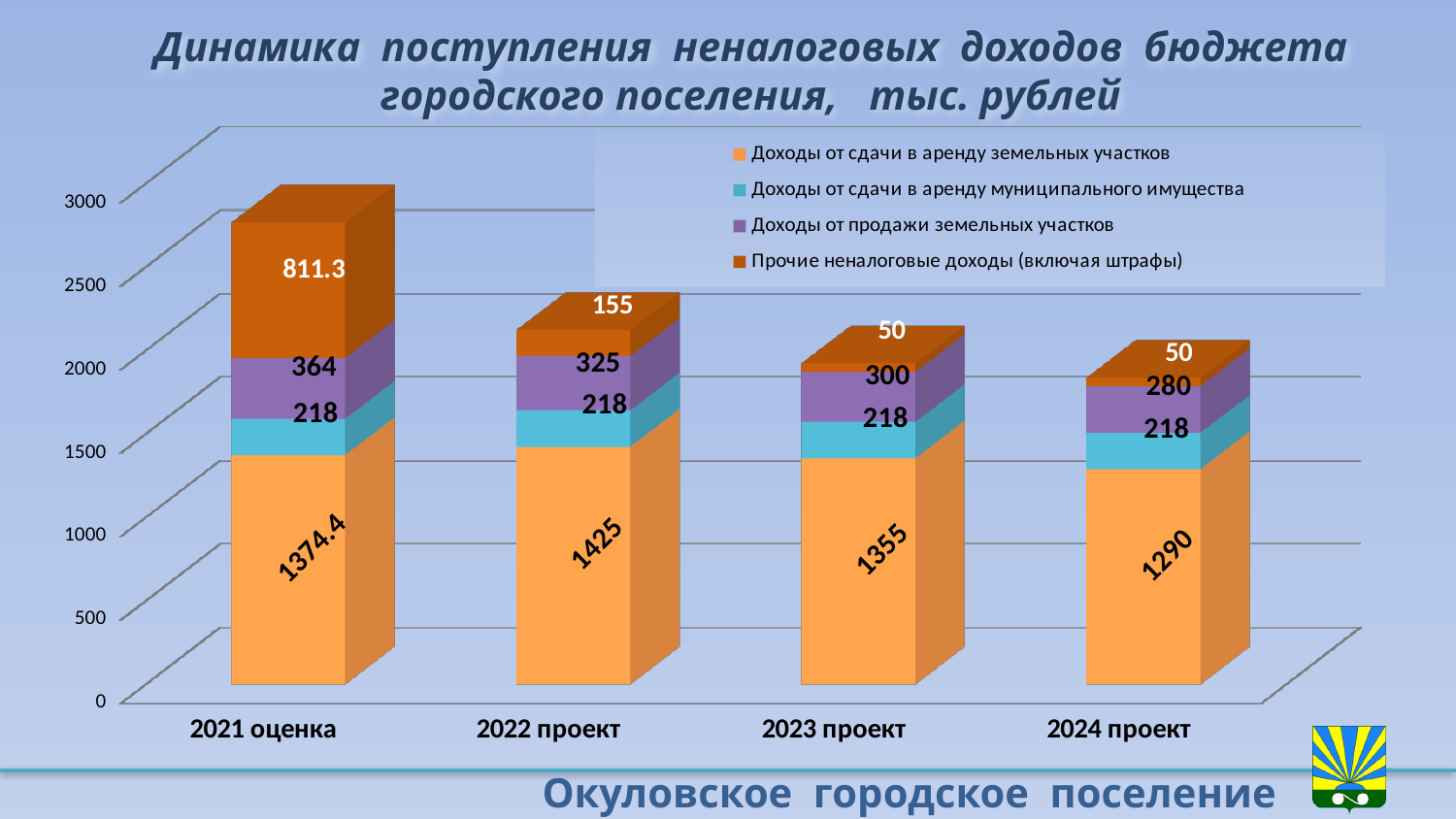
Which category has the lowest value for 'Доходы от продажи земельных участков'? 2024 проект Do the values for 'Доходы от продажи земельных участков' rise or fall from 2021 оценка to 2024 проект? fall What is the total of the stacked bar for 2023 проект? 1923 How many categories are shown on the x axis? 4 How many series does the legend list? 4 Which is larger: 'Доходы от сдачи в аренду земельных участков' for 2023 проект or for 2024 проект? 2023 проект What is the difference between 'Прочие неналоговые доходы (включая штрафы)' for 2021 оценка and 2022 проект? 656.3 What type of chart is shown on the slide? stacked bar chart What is the value of 'Доходы от продажи земельных участков' for 2024 проект? 280 What is the value of 'Доходы от сдачи в аренду земельных участков' for 2022 проект? 1425 Which category has the highest value for 'Доходы от сдачи в аренду земельных участков'? 2022 проект What is the value of 'Прочие неналоговые доходы (включая штрафы)' for 2021 оценка? 811.3